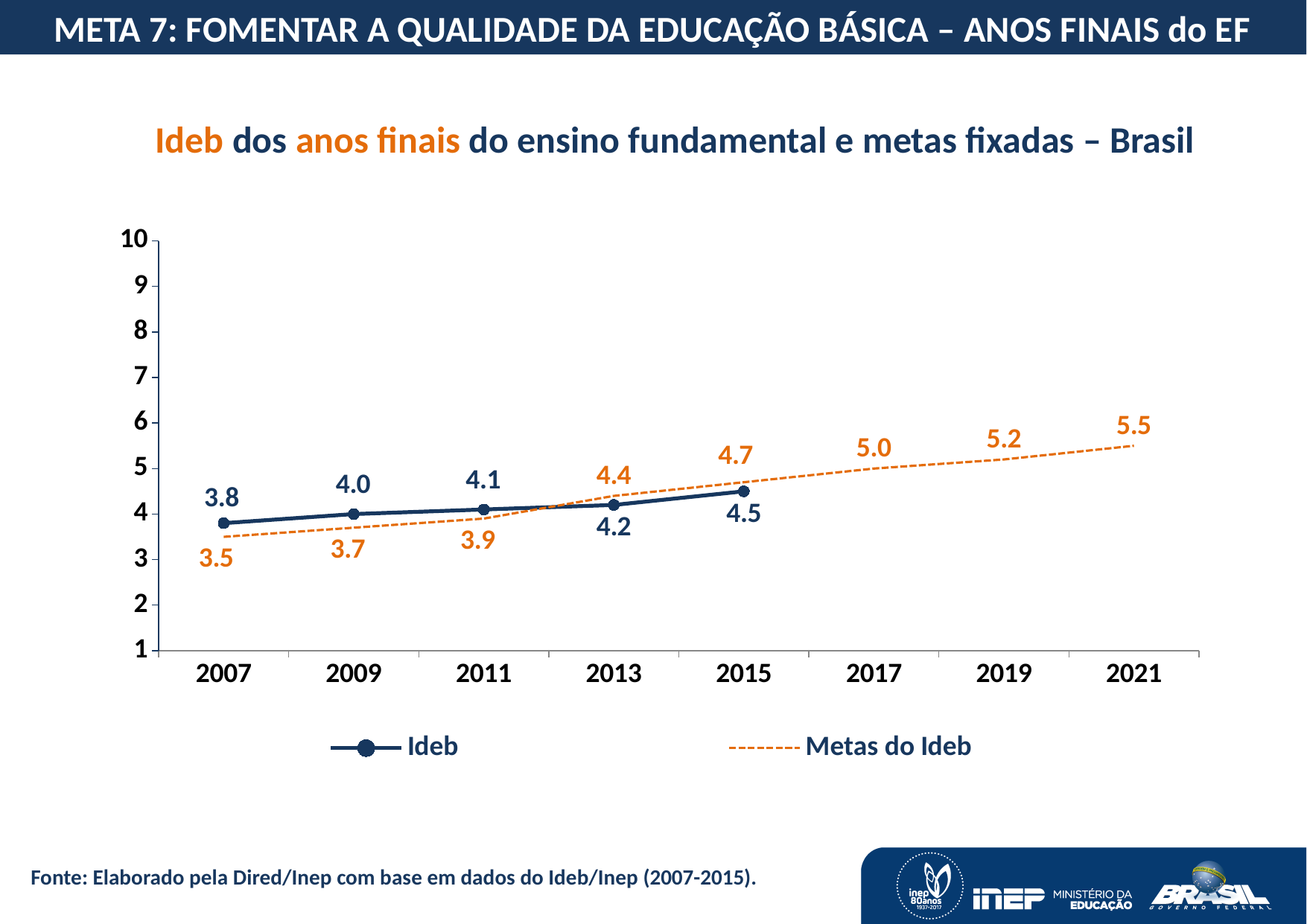
Does the Metas do Ideb series rise or fall from 2007 to 2021? Rise How many series does the legend list? 2 In 2009, which is larger: the Ideb value or the Metas do Ideb value? Ideb What kind of chart is this? Line chart What is the Ideb value for 2015? 4.5 In which year is the Metas do Ideb series lowest? 2007 How many years are shown on the x axis? 8 What is the Metas do Ideb value for 2007? 3.5 In which year is the Ideb series highest? 2015 What is the difference between the Metas do Ideb value and the Ideb value in 2015? 0.2 What is the Metas do Ideb value for 2021? 5.5 What is the Ideb value for 2011? 4.1